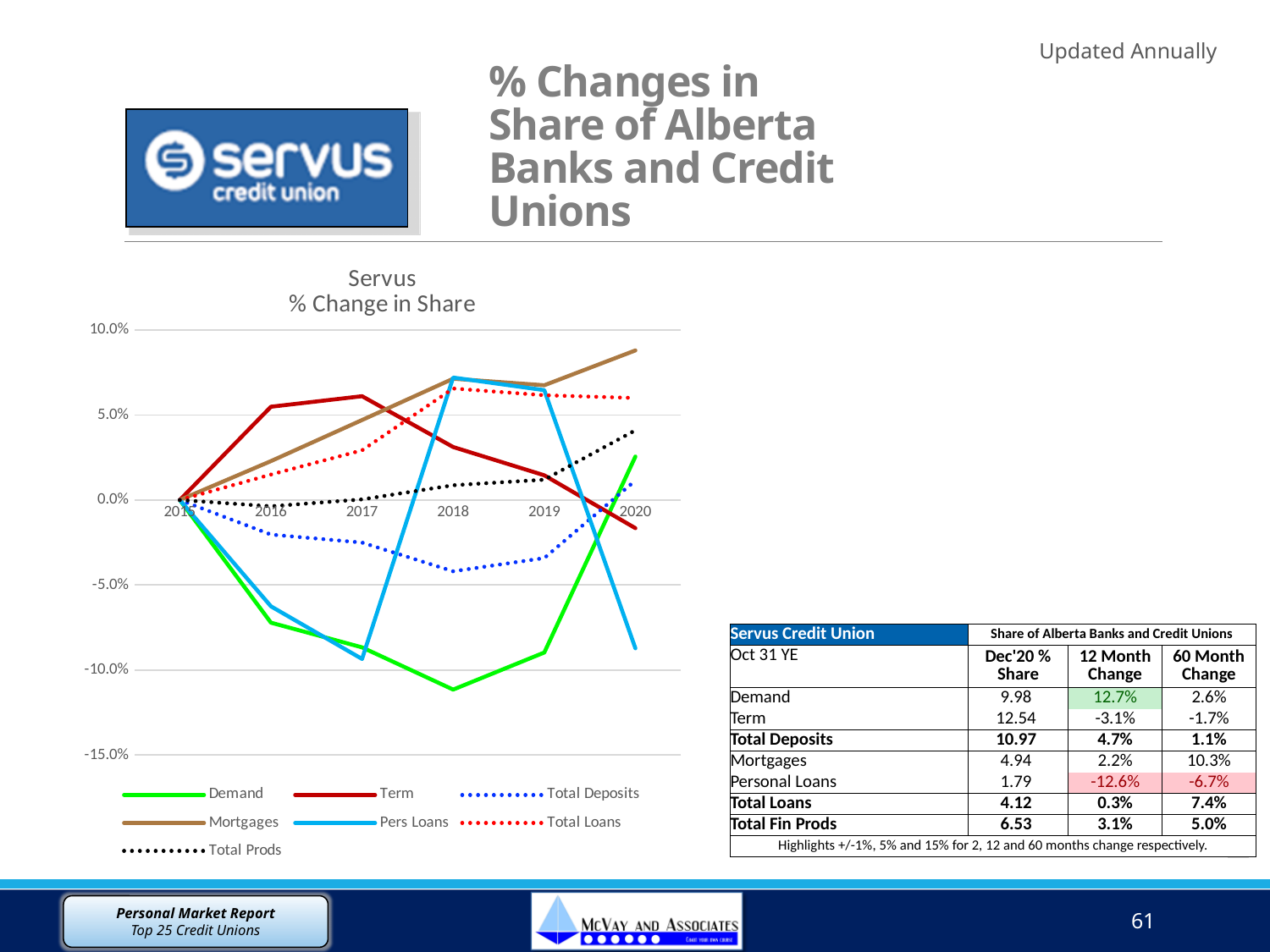
What is the title of the chart? Servus % Change in Share How many series does the legend of the chart list? 7 Does the Mortgages line rise or fall from 2015 to 2020? rise Which series has the lowest value in 2020? Pers Loans Which series has the lowest value in 2018? Demand Is the value for Mortgages in 2020 greater or less than 5.0%? greater How many years are shown along the x axis of the chart? 6 Which is larger in 2020, the value for Demand or the value for Term? Demand What colour is the Demand line in the chart? green Is the value for Demand in 2018 greater or less than -10.0%? less What kind of chart is shown on the slide? line chart Which series has the highest value in 2020? Mortgages